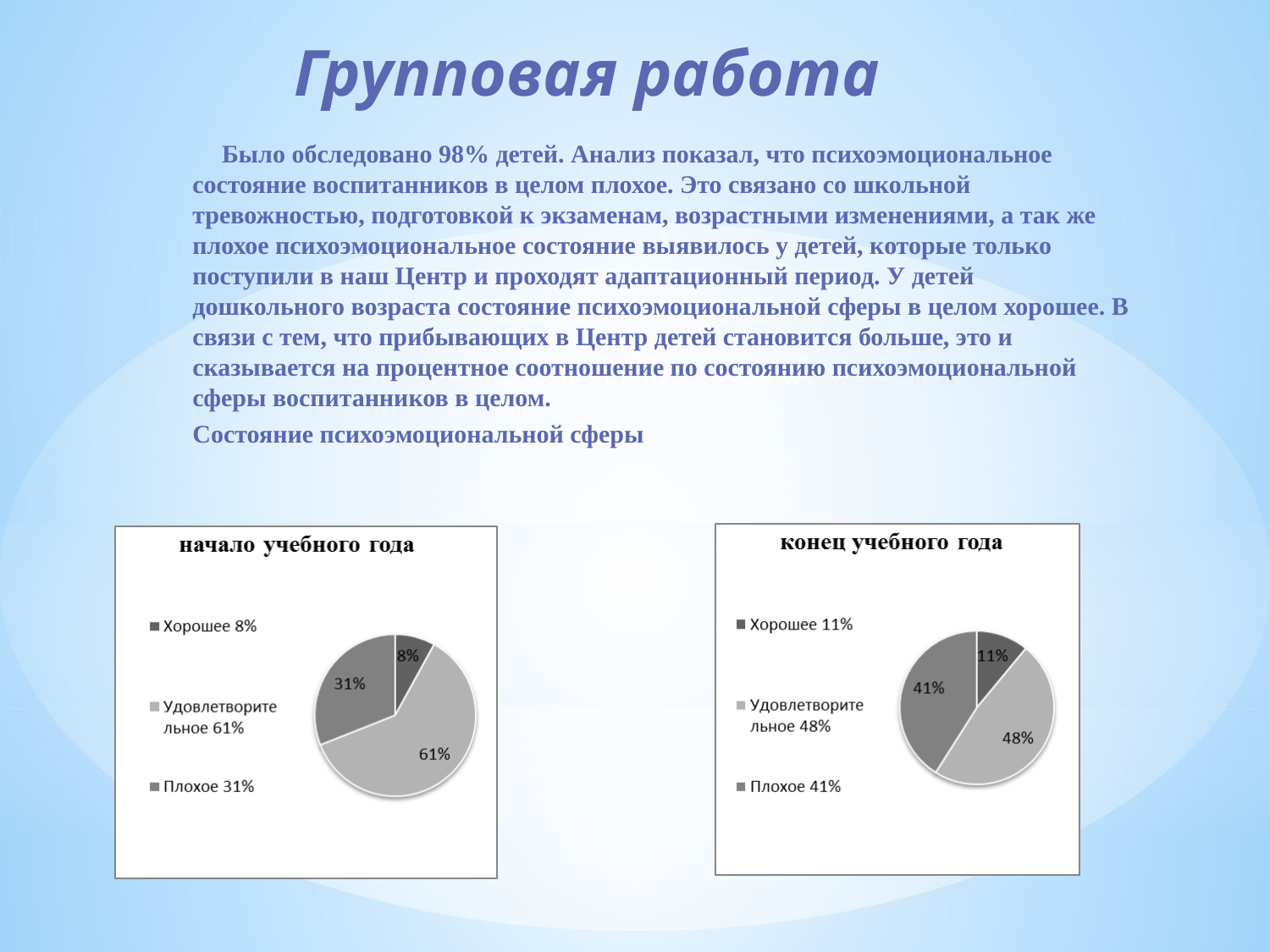
In the chart titled "конец учебного года", what is the difference between the "Плохое" and "Хорошее" shares? 30% In the chart titled "начало учебного года", which category has the largest slice? Удовлетворительное In the chart titled "конец учебного года", what share does "Плохое" have? 41% In the chart titled "начало учебного года", what is the difference between the "Удовлетворительное" and "Плохое" shares? 30% In the chart titled "начало учебного года", what share does "Удовлетворительное" have? 61% What is the title of the chart on the left side of the slide? начало учебного года How many categories does the chart titled "начало учебного года" show? 3 In the chart titled "начало учебного года", what share does "Хорошее" have? 8% What type of chart is the chart titled "конец учебного года"? Pie chart Is the "Плохое" share larger in the chart titled "начало учебного года" or in the chart titled "конец учебного года"? конец учебного года In the chart titled "конец учебного года", what share does "Удовлетворительное" have? 48% In the chart titled "конец учебного года", which category has the smallest slice? Хорошее